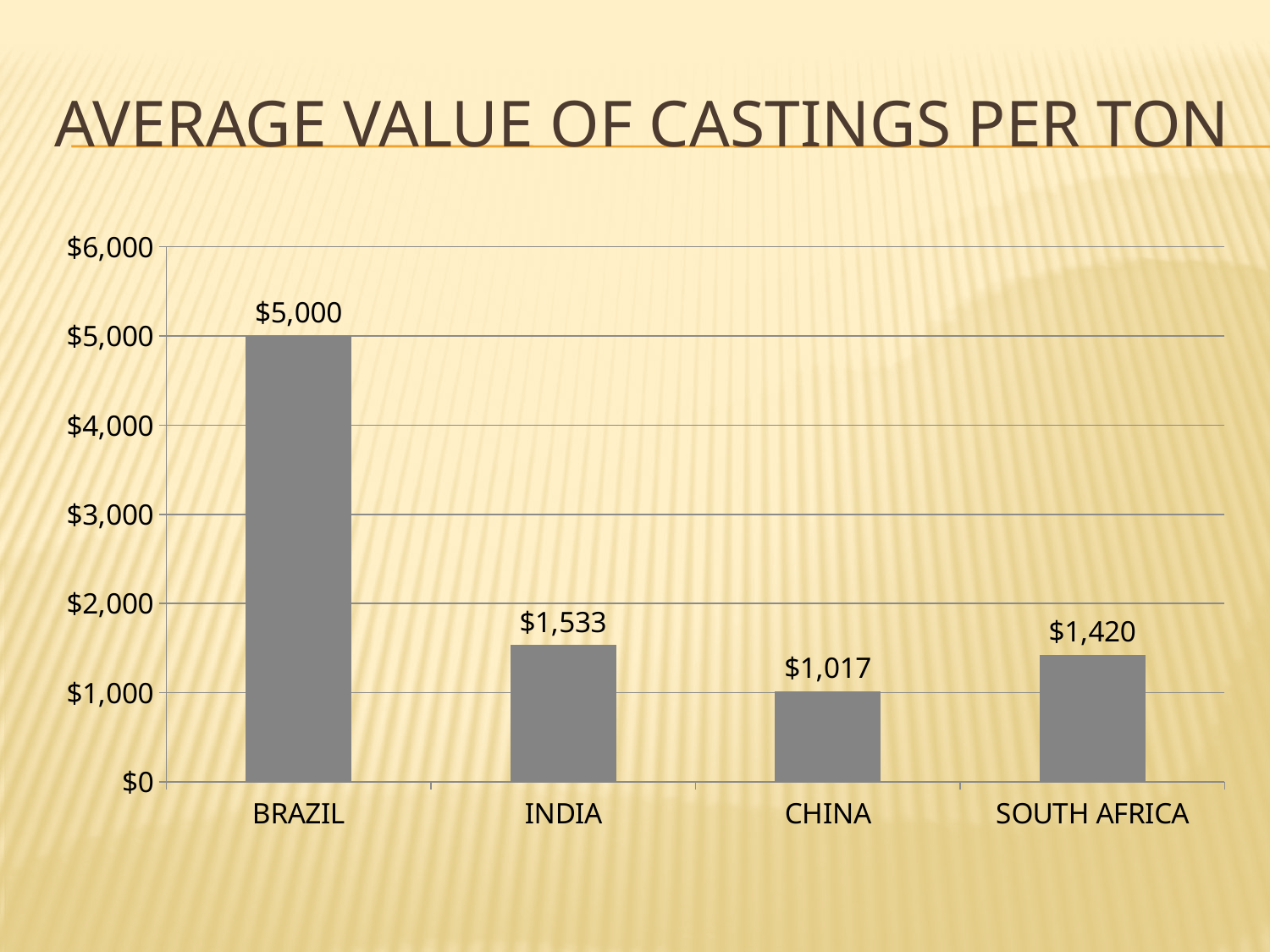
What is the difference between the values for Brazil and India? $3,467 Which country has the highest average value of castings per ton? Brazil How many countries are shown in the chart? 4 Which has a higher average value of castings per ton, South Africa or China? South Africa What is the average value of castings per ton for China? $1,017 What is the title of the slide? Average Value of Castings Per Ton What kind of chart is shown on the slide? Bar chart What is the average value of castings per ton for India? $1,533 What is the difference between the values for India and South Africa? $113 What is the average value of castings per ton for South Africa? $1,420 What is the average value of castings per ton for Brazil? $5,000 Which country has the lowest average value of castings per ton? China